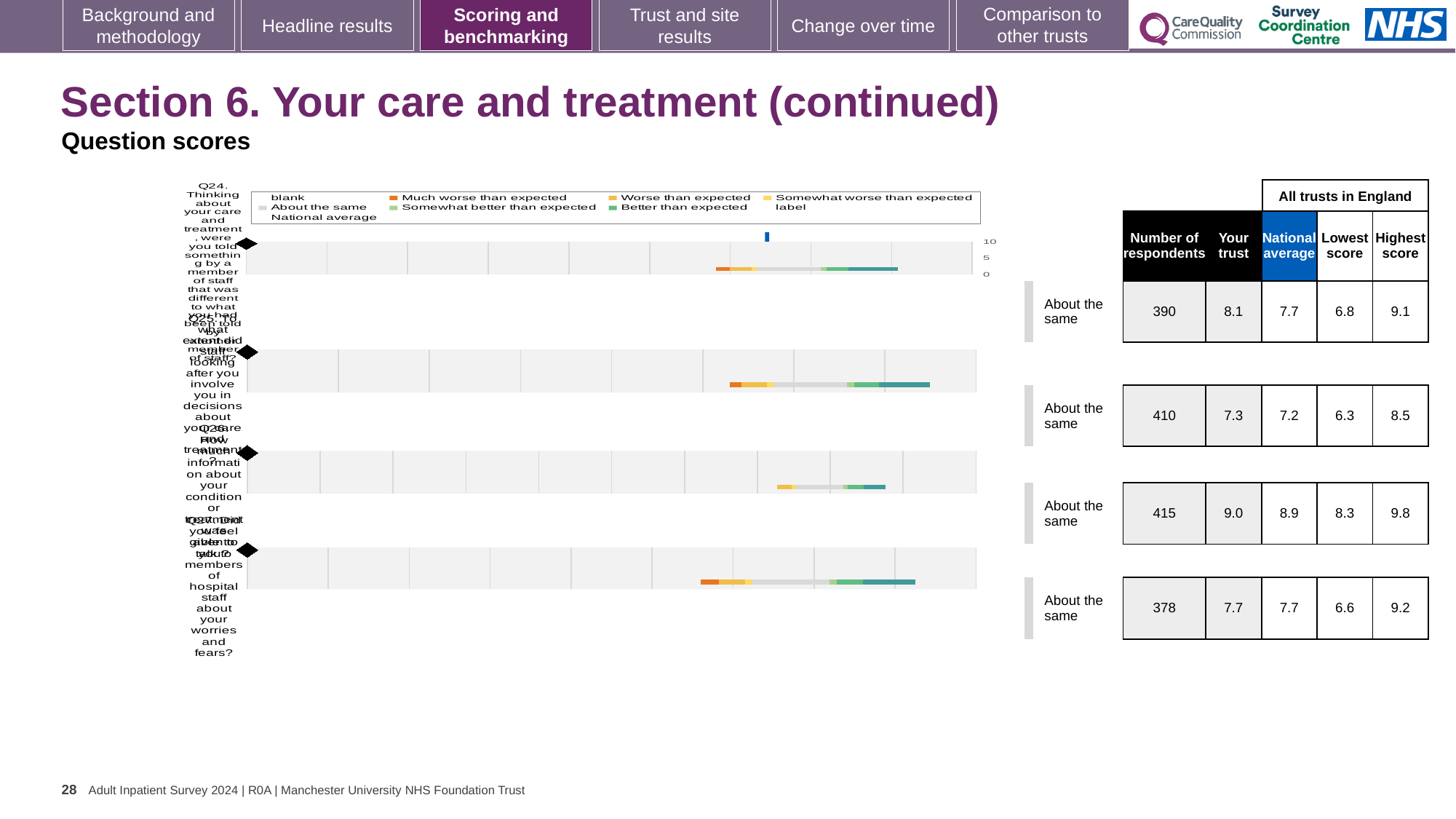
What benchmark category label is shown next to each of the four question charts? About the same Which legend entry is shown in orange-red in the chart legend? Much worse than expected How many question charts (Q24 to Q27) are shown on the slide? 4 What kind of chart is used to show the question scores on this slide? Bar chart For the first chart (Q24), what is the 'Your trust' score in the table? 8.1 For the first chart (Q24), what is the difference between the 'Your trust' score and the national average? 0.4 Which question chart has the lowest 'Your trust' score? Q25 (7.3) For the fourth chart (Q27), what is the highest score among all trusts in England? 9.2 Which question chart has the highest 'Your trust' score? Q26 (9.0) For the fourth chart (Q27), is the 'Your trust' score higher than, lower than, or the same as the national average? The same For the third chart (Q26), how many respondents are listed? 415 For the second chart (Q25), what is the national average score? 7.2